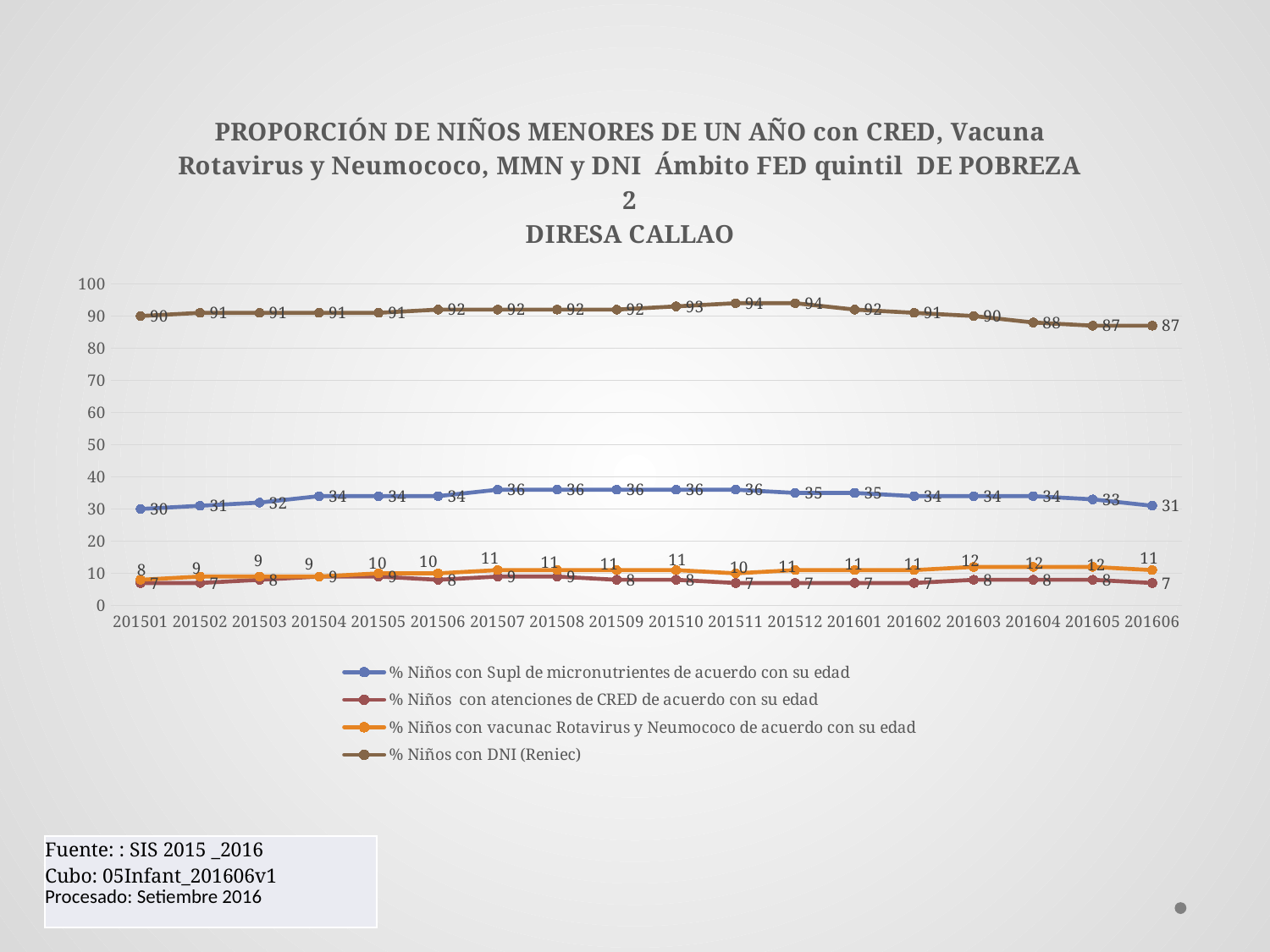
What kind of chart is shown on the slide? Line chart In which periods does % Niños con DNI (Reniec) reach its highest value? 201511 and 201512 What is the value of % Niños con DNI (Reniec) for 201606? 87 Does % Niños con DNI (Reniec) rise or fall from 201512 to 201606? Fall What is the value of % Niños con Supl de micronutrientes de acuerdo con su edad for 201501? 30 What is the value of % Niños con vacunac Rotavirus y Neumococo de acuerdo con su edad for 201603? 12 What is the difference between % Niños con DNI (Reniec) and % Niños con Supl de micronutrientes de acuerdo con su edad in 201606? 56 Which series has the higher value in 201507: % Niños con vacunac Rotavirus y Neumococo or % Niños con atenciones de CRED? % Niños con vacunac Rotavirus y Neumococo de acuerdo con su edad How many series does the legend list? 4 How many periods are shown on the x axis? 18 What is the lowest value of % Niños con Supl de micronutrientes de acuerdo con su edad? 30 Is the value of % Niños con DNI (Reniec) for 201511 greater or less than 90? greater